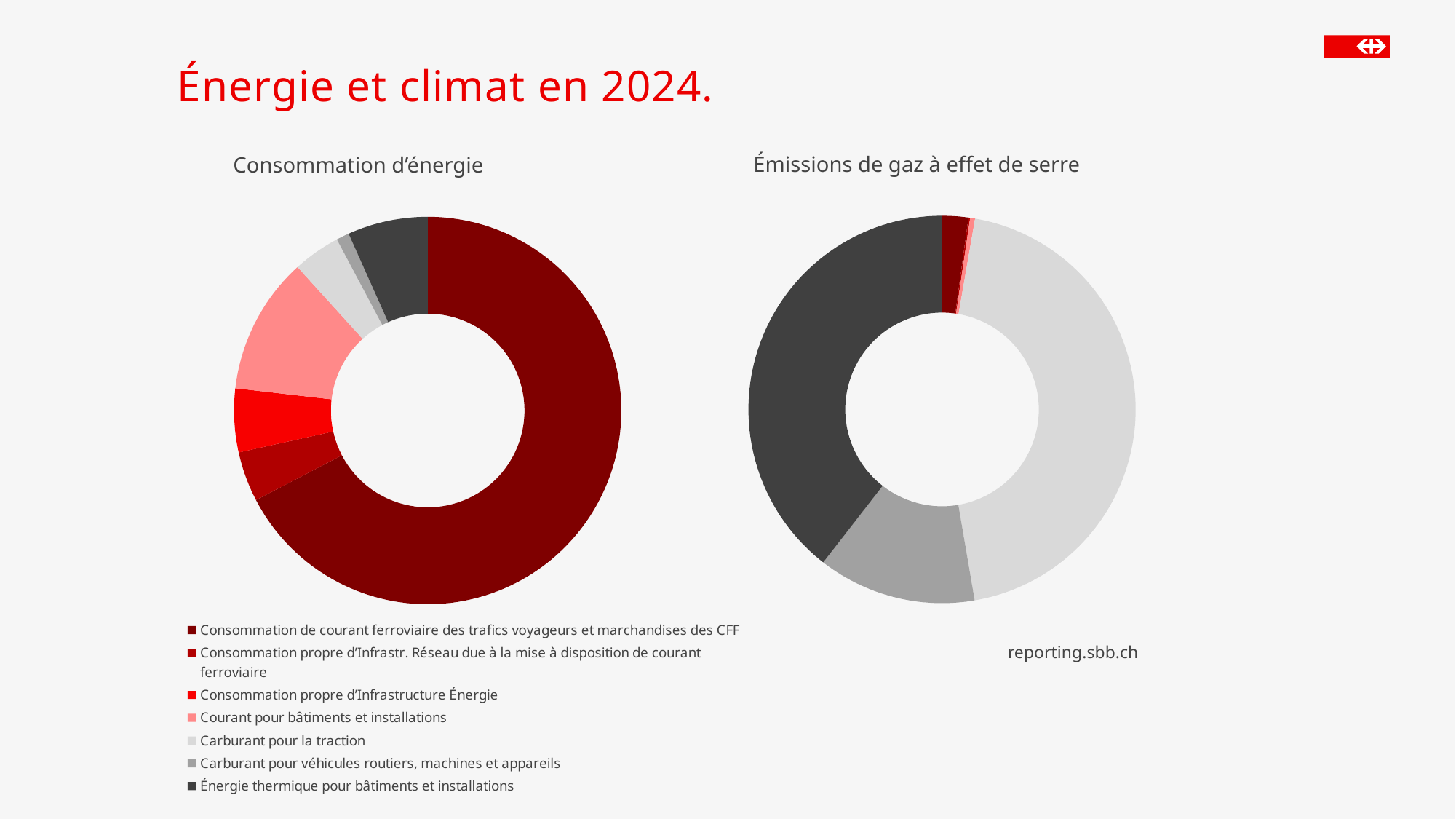
What is the title of the chart on the left of the slide? Consommation d'énergie In the 'Consommation d'énergie' chart, which category has the largest slice? Consommation de courant ferroviaire des trafics voyageurs et marchandises des CFF In the 'Consommation d'énergie' chart, which category has the smallest slice? Carburant pour véhicules routiers, machines et appareils What is the title of the chart on the right of the slide? Émissions de gaz à effet de serre In the 'Émissions de gaz à effet de serre' chart, which slice is larger: 'Carburant pour la traction' or 'Énergie thermique pour bâtiments et installations'? Carburant pour la traction In the 'Consommation d'énergie' chart, which slice is larger: 'Courant pour bâtiments et installations' or 'Carburant pour la traction'? Courant pour bâtiments et installations In the 'Émissions de gaz à effet de serre' chart, which category has the largest slice? Carburant pour la traction In the 'Émissions de gaz à effet de serre' chart, which slice is larger: 'Énergie thermique pour bâtiments et installations' or 'Carburant pour véhicules routiers, machines et appareils'? Énergie thermique pour bâtiments et installations What kind of chart is the 'Consommation d'énergie' chart? doughnut chart How many categories does the legend list? 7 What kind of chart is the 'Émissions de gaz à effet de serre' chart? doughnut chart